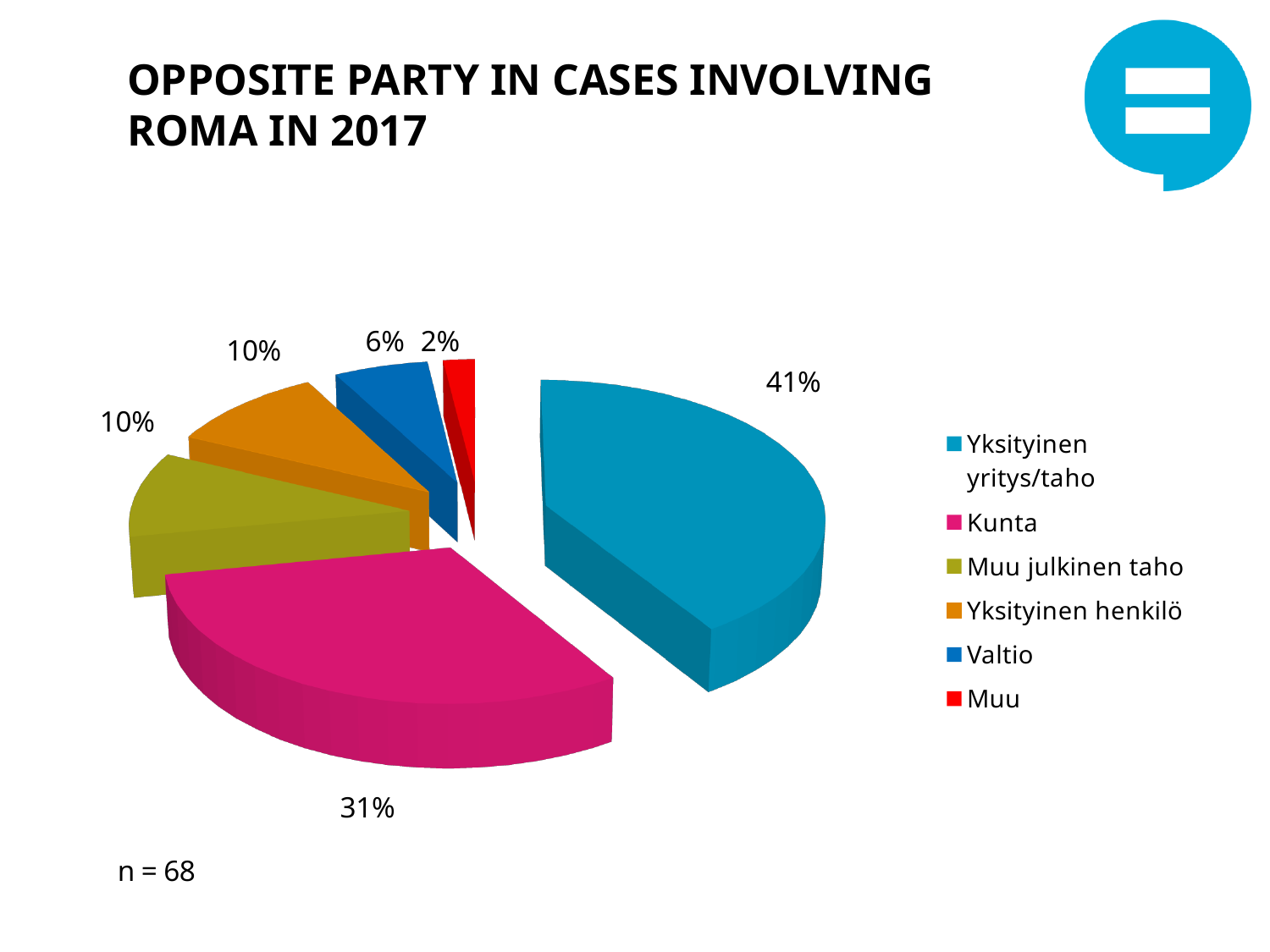
How many categories are shown in the pie chart? 6 What is the sample size (n) stated on the slide? n = 68 What share of the pie does Kunta represent? 31% What type of chart is shown on the slide? Pie chart What share of the pie does Valtio represent? 6% Which category has the smallest slice of the pie? Muu What is the difference in percentage points between Yksityinen yritys/taho and Kunta? 10 percentage points What share of the pie does Muu represent? 2% Which is larger, the share for Valtio or the share for Muu? Valtio Which category has the largest slice of the pie? Yksityinen yritys/taho